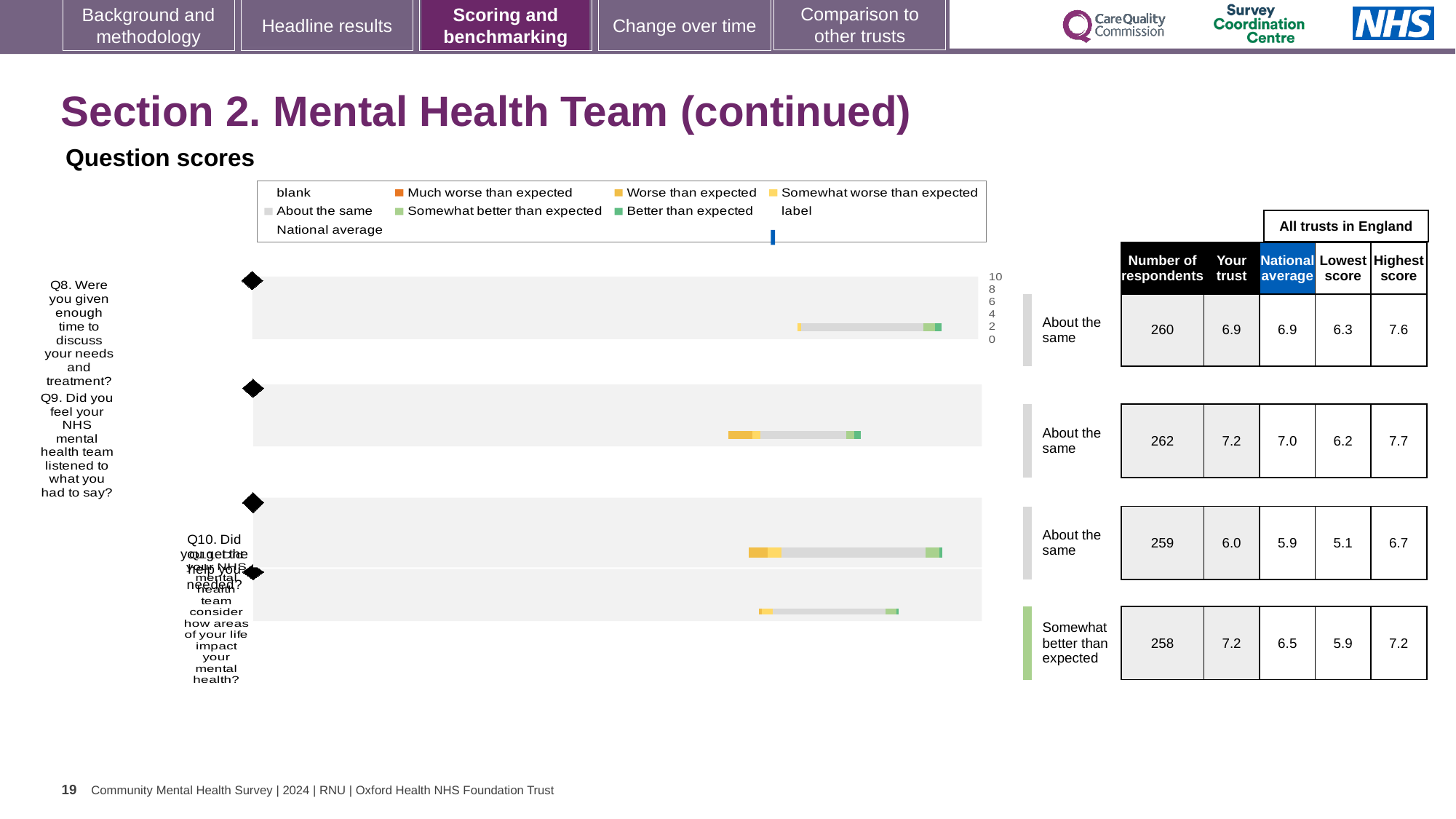
Which question has the lowest 'Your trust' score? Q10 What is the national average score for Q10 (Did you get the help you needed?)? 5.9 What is the highest score among all trusts in England for Q9? 7.7 What is the lowest score among all trusts in England for Q10? 5.1 What benchmark category is shown for the bottom row (Q11) of the chart? Somewhat better than expected What is the 'Your trust' score for Q8 (Were you given enough time to discuss your needs and treatment?)? 6.9 What kind of chart is used to show the question scores on this slide? bar chart What is the number of respondents for Q9 (Did you feel your NHS mental health team listened to what you had to say?)? 262 Is the 'Your trust' score for Q9 larger or smaller than the national average for Q9? larger What is the difference between the 'Your trust' score and the national average for Q11 (the bottom row)? 0.7 Which legend entry is shown in orange? Much worse than expected How many question rows (bars) are plotted in the question scores chart? 4